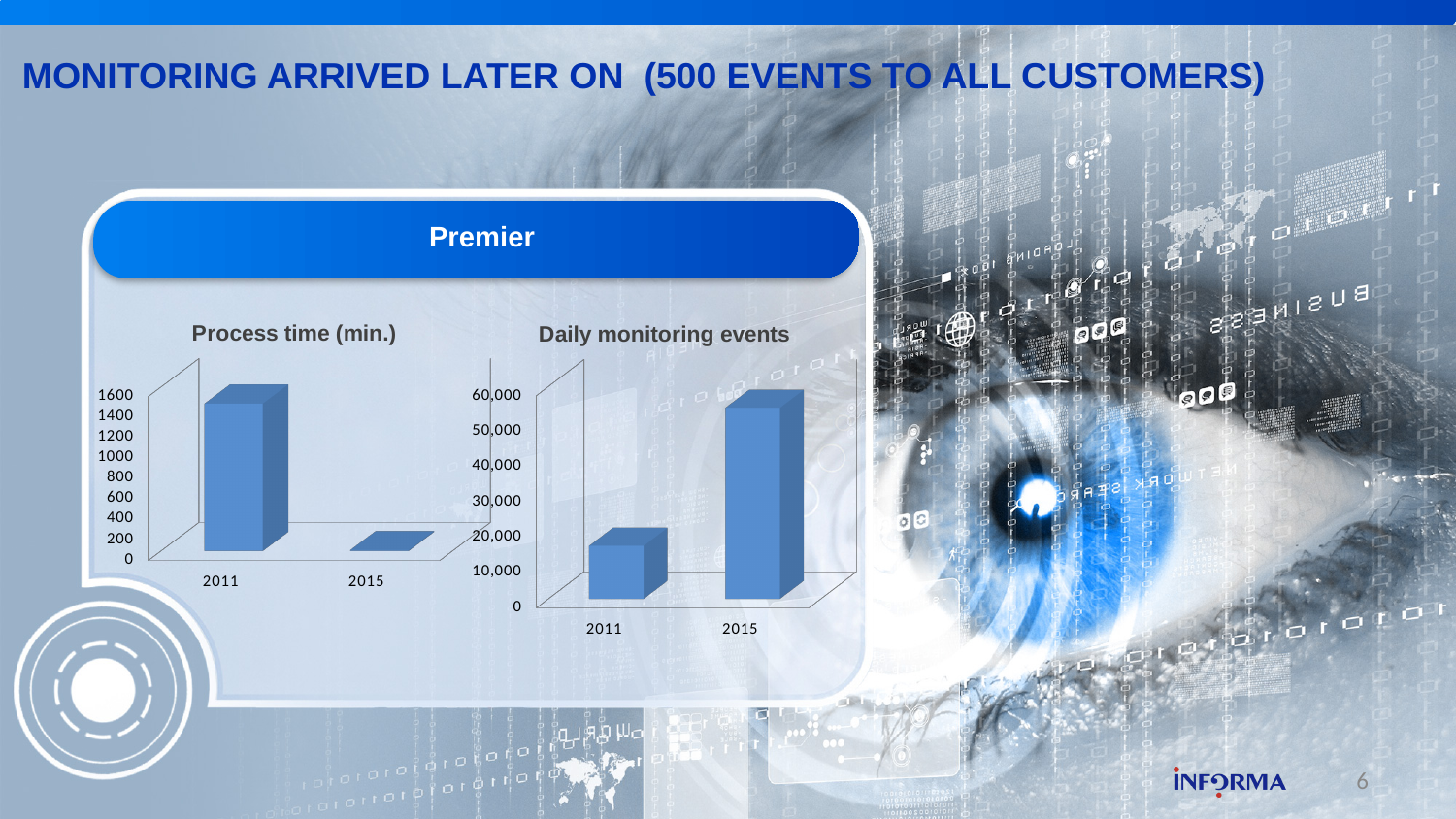
In the 'Process time (min.)' chart, do the values rise or fall from 2011 to 2015? fall In the 'Daily monitoring events' chart, is the value for 2011 greater or less than 20,000? less In the 'Process time (min.)' chart, is the value for 2015 greater or less than 400? less How many categories are shown on the x axis of the 'Daily monitoring events' chart? 2 In the 'Process time (min.)' chart, which year has the lowest value? 2015 In the 'Process time (min.)' chart, which year has the highest value? 2011 In the 'Daily monitoring events' chart, which year has the lowest value? 2011 In the 'Daily monitoring events' chart, which year has the highest value? 2015 In the 'Daily monitoring events' chart, is the value for 2015 greater or less than 40,000? greater What kind of chart is the 'Process time (min.)' chart? bar chart What kind of chart is the 'Daily monitoring events' chart? bar chart